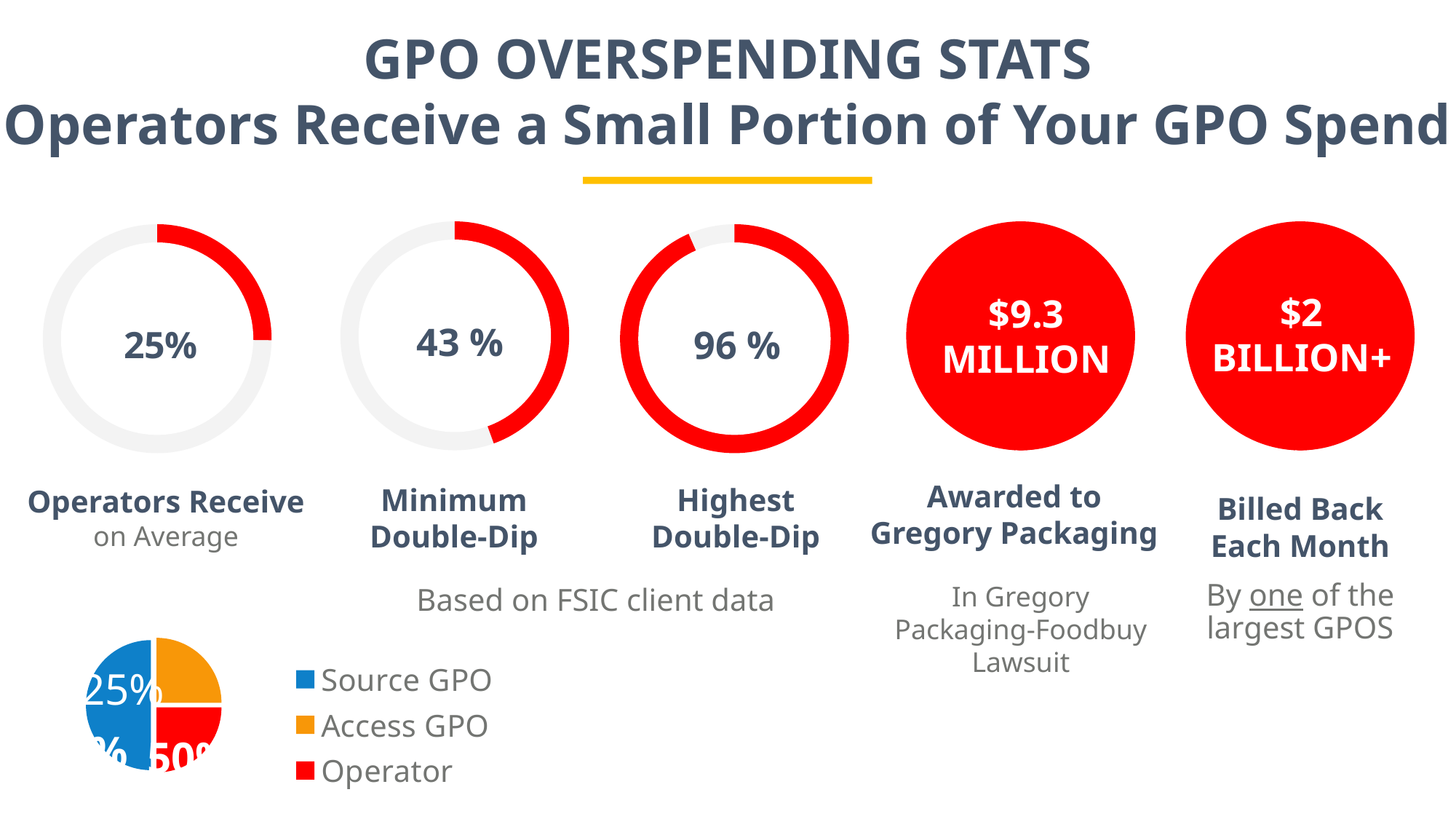
What is the difference between the Highest Double-Dip and Minimum Double-Dip percentages? 53 % How many entries does the legend of the bottom-left pie chart list? 3 What kind of chart is shown at the bottom left of the slide? Pie chart In the bottom-left pie chart legend, which colour represents 'Operator'? Red Which of the three donut charts shows the lowest percentage? Operators Receive on Average What value is shown in the 'Highest Double-Dip' donut chart? 96 % How many donut charts are shown on the slide? 3 Which is larger, the Minimum Double-Dip value or the Operators Receive on Average value? Minimum Double-Dip What percentage is shown in the 'Operators Receive on Average' donut chart? 25% Which of the three donut charts shows the highest percentage? Highest Double-Dip What value is shown in the 'Minimum Double-Dip' donut chart? 43 % In the bottom-left pie chart legend, which category is shown in orange? Access GPO